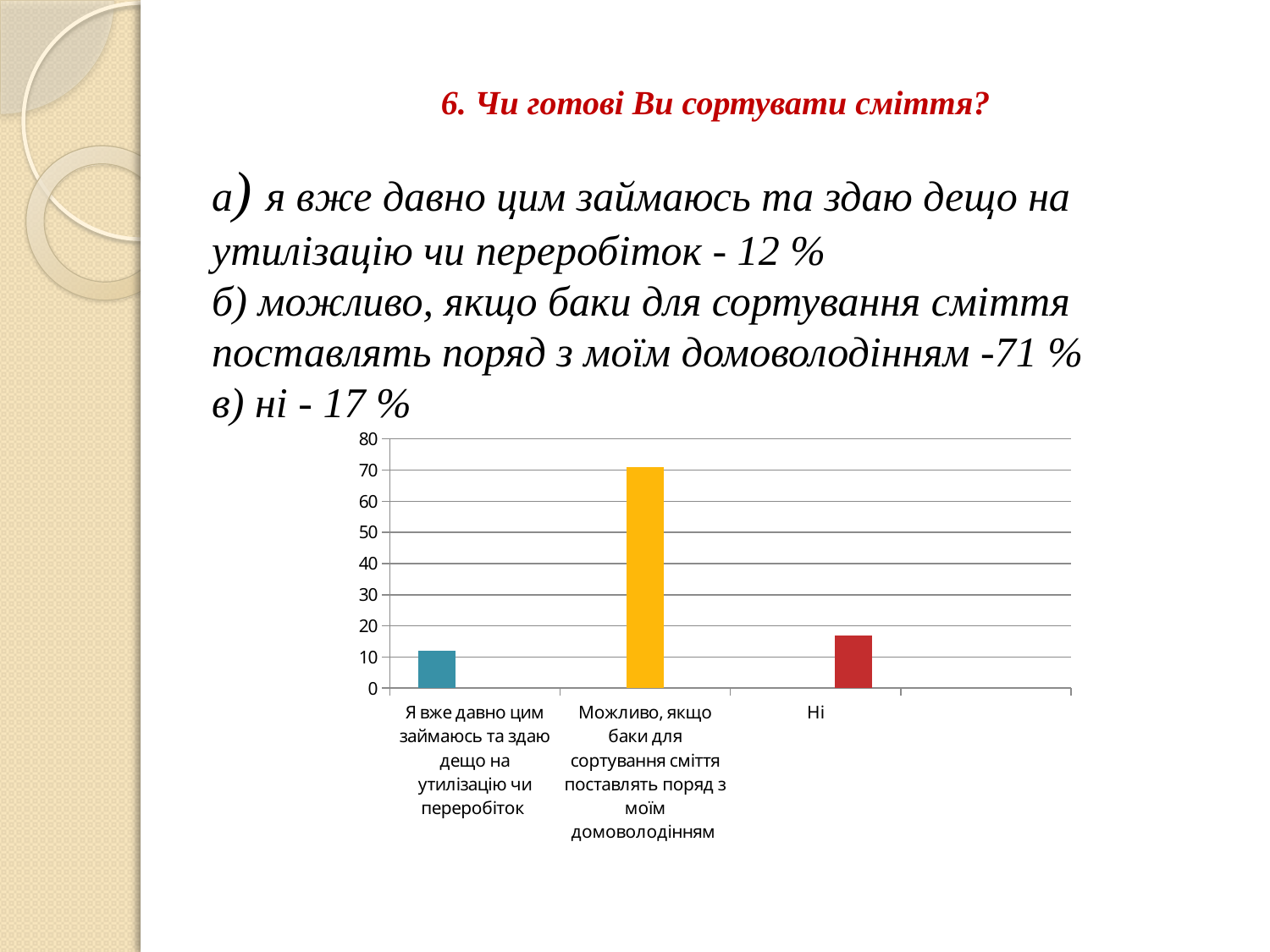
Is the value for 'Можливо, якщо баки для сортування сміття поставлять поряд з моїм домоволодінням' greater or less than 60? greater What type of chart is shown on the slide? bar chart According to the slide, what percentage of respondents answered 'Ні'? 17 % Which is larger: the bar for 'Ні' or the bar for 'Я вже давно цим займаюсь та здаю дещо на утилізацію чи переробіток'? Ні What is the difference between the percentage for 'Можливо, якщо баки для сортування сміття поставлять поряд з моїм домоволодінням' and the percentage for 'Ні'? 54 % Is the value for 'Ні' greater or less than 20? less According to the slide, what percentage of respondents answered 'Я вже давно цим займаюсь та здаю дещо на утилізацію чи переробіток'? 12 % How many categories (bars) does the chart show? 3 Which category has the highest bar in the chart? Можливо, якщо баки для сортування сміття поставлять поряд з моїм домоволодінням According to the slide, what percentage of respondents answered 'Можливо, якщо баки для сортування сміття поставлять поряд з моїм домоволодінням'? 71 % What colour is the bar for 'Ні'? red Which category has the lowest bar in the chart? Я вже давно цим займаюсь та здаю дещо на утилізацію чи переробіток